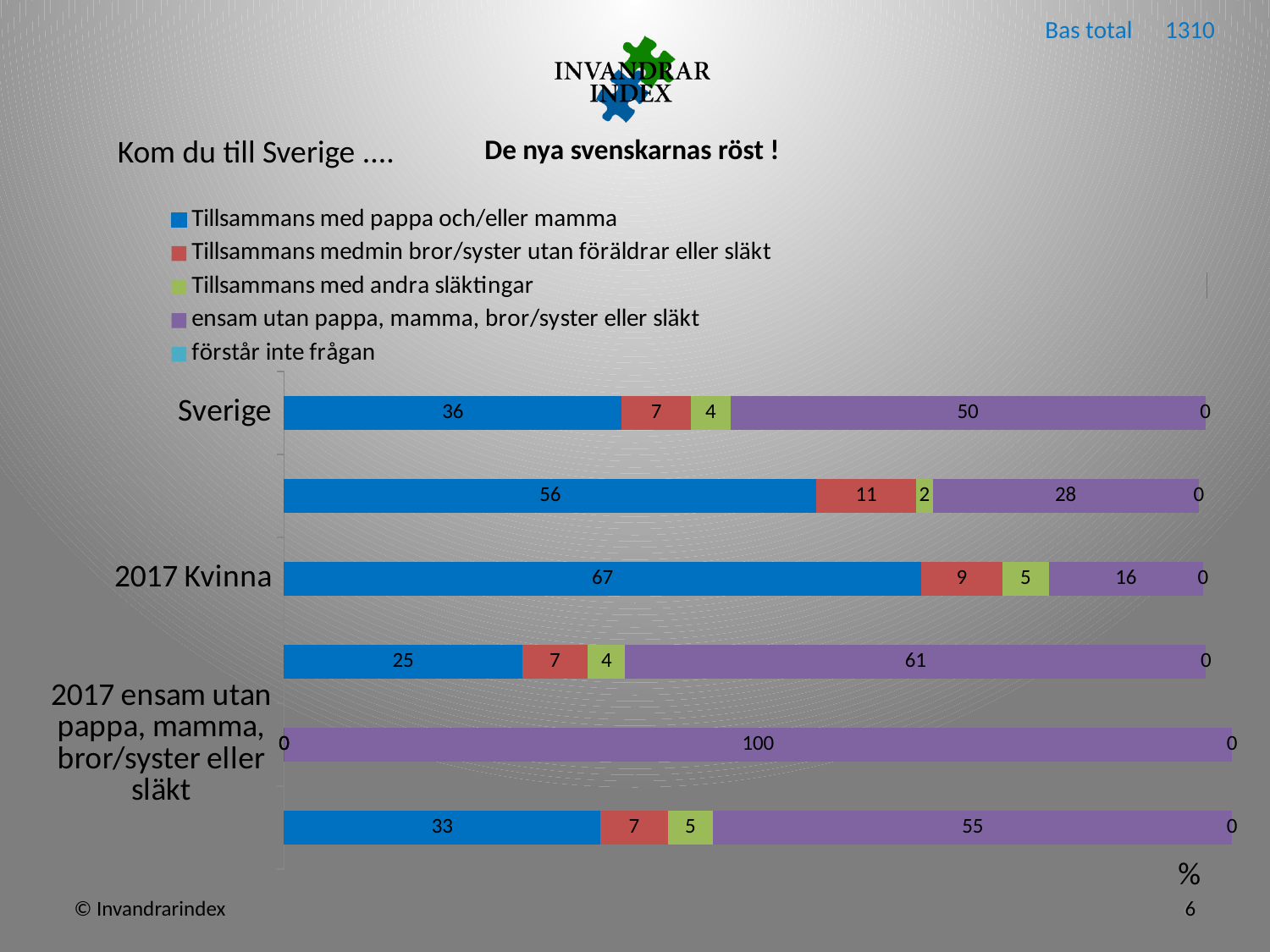
What is the value for 'ensam utan pappa, mamma, bror/syster eller släkt' in the 2017 Kvinna bar? 16 Which has the larger value for 'ensam utan pappa, mamma, bror/syster eller släkt': Sverige or 2017 Kvinna? Sverige What is the value for 'Tillsammans med pappa och/eller mamma' in the Sverige bar? 36 Which has the larger value for 'Tillsammans med pappa och/eller mamma': Sverige or 2017 Kvinna? 2017 Kvinna How many series does the legend list? 5 What kind of chart is shown on the slide? Stacked bar chart What is the value for 'ensam utan pappa, mamma, bror/syster eller släkt' in the Sverige bar? 50 What is the value for 'Tillsammans medmin bror/syster utan föräldrar eller släkt' in the 2017 Kvinna bar? 9 In the Sverige bar, what is the difference between the 'ensam utan pappa, mamma, bror/syster eller släkt' value and the 'Tillsammans med pappa och/eller mamma' value? 14 What is the total of the stacked Sverige bar? 97 What is the value for 'ensam utan pappa, mamma, bror/syster eller släkt' in the bar labelled '2017 ensam utan pappa, mamma, bror/syster eller släkt'? 100 What is the question text shown above the chart? Kom du till Sverige ....